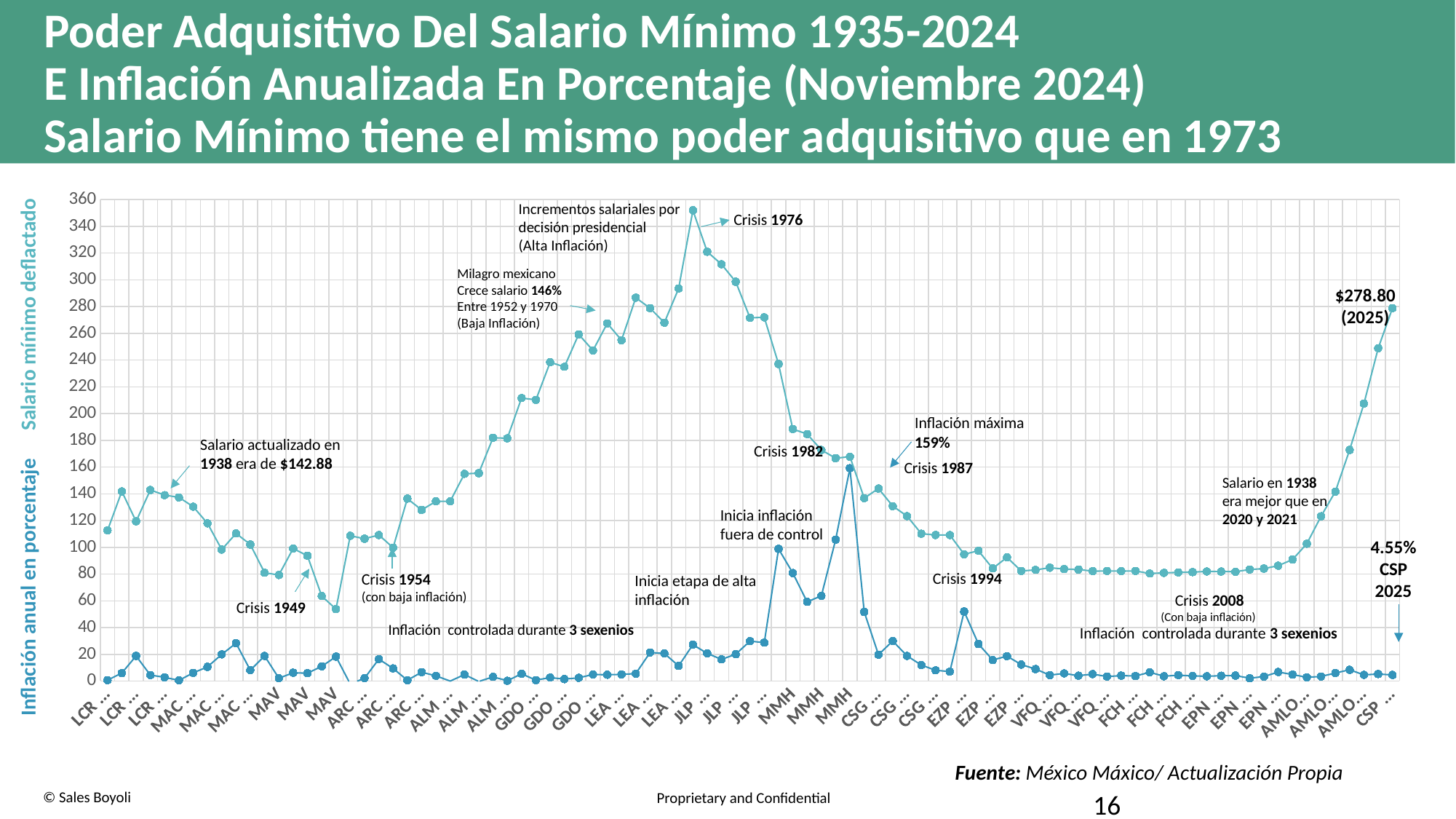
Is the lowest point of the deflated minimum wage line (around the 1954 crisis) greater or less than 60? less What annual inflation percentage is annotated for CSP 2025? 4.55% Is the peak value of the deflated minimum wage line (around 1976) greater or less than 340? greater What is the deflated minimum wage value annotated for 2025? $278.80 What kind of chart is shown on the slide? line chart Which is larger, the annotated deflated minimum wage for 2025 or for 1938? 2025 What is the difference between the annotated deflated minimum wage for 2025 ($278.80) and for 1938 ($142.88)? $135.92 Near which annotated crisis does the deflated minimum wage line reach its highest point? Crisis 1976 Does the deflated minimum wage line rise or fall between the 1976 peak and the 1982 crisis? fall According to the annotation, what was the updated minimum wage in 1938? $142.88 What maximum inflation value is annotated near the 1987 crisis? 159% What is the highest value shown on the vertical axis? 360